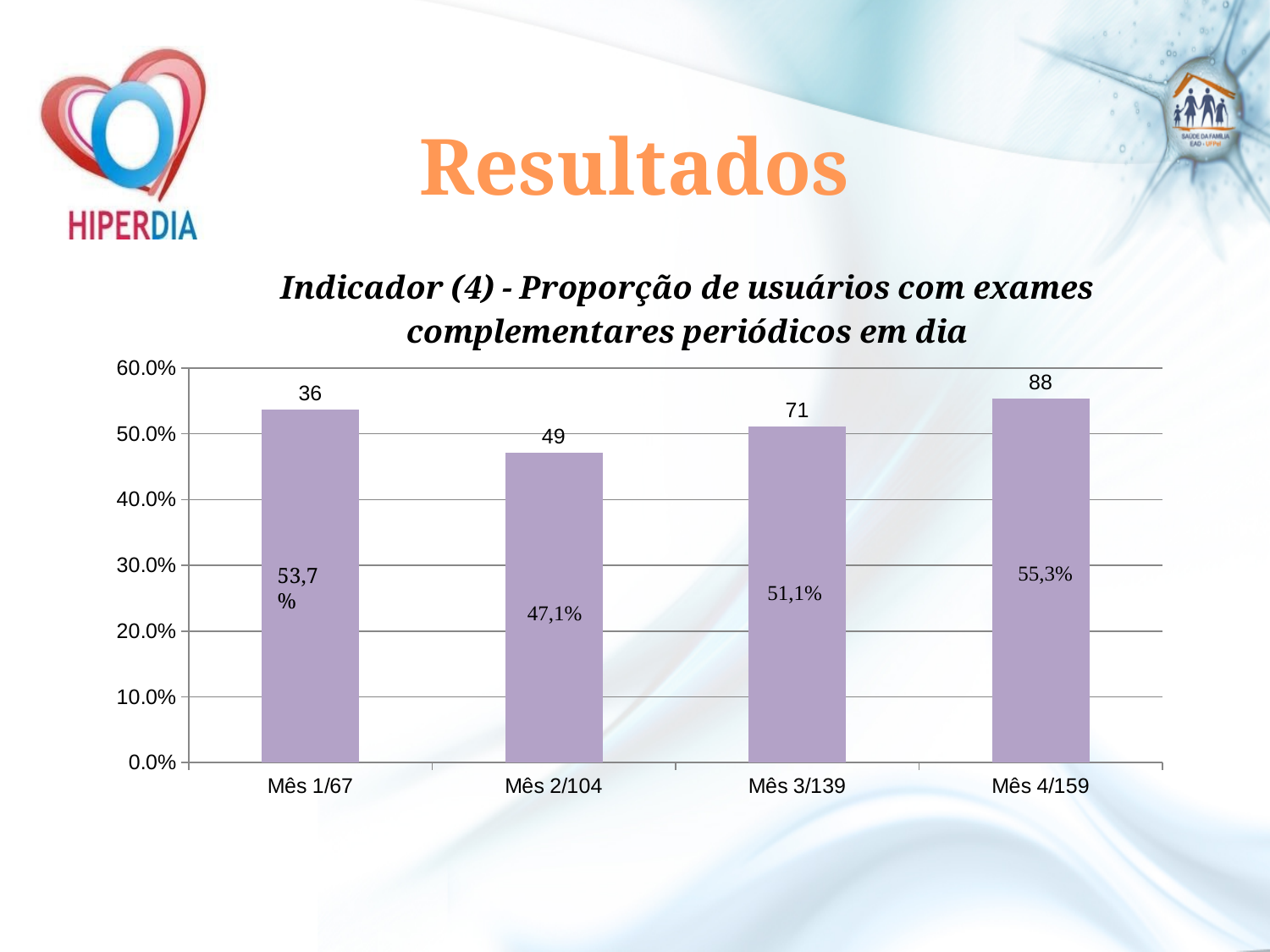
What kind of chart is shown on the slide? bar chart What number is printed above the bar for Mês 3/139? 71 What is the difference between the numbers printed above the bars for Mês 4/159 and Mês 1/67? 52 Which category has the highest bar? Mês 4/159 What percentage is shown inside the bar for Mês 4/159? 55,3% What number is printed above the bar for Mês 1/67? 36 Which category has the lowest bar? Mês 2/104 Is the value for Mês 2/104 greater or less than 50.0%? less How many categories are shown on the x axis? 4 What percentage is shown inside the bar for Mês 2/104? 47,1% What is the title of the chart? Indicador (4) - Proporção de usuários com exames complementares periódicos em dia Which bar is taller, Mês 1/67 or Mês 3/139? Mês 1/67